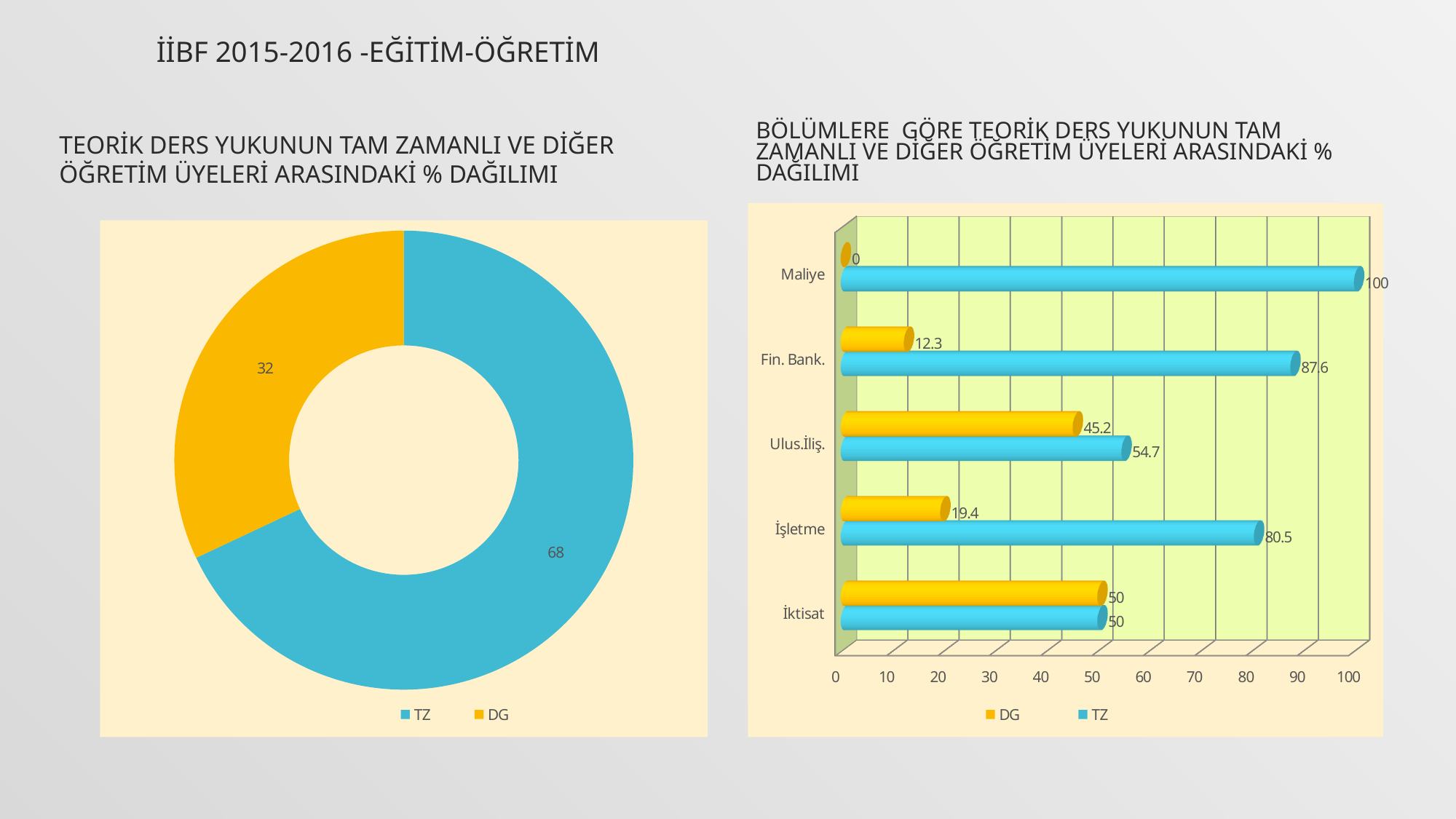
In the left chart (doughnut), what is the value for TZ? 68 In the right chart (bar chart by department), what is the TZ value for İşletme? 80.5 How many departments are shown in the right chart (bar chart by department)? 5 How many series does the legend of the right chart (bar chart by department) list? 2 In the right chart (bar chart by department), what is the difference between the TZ and DG values for Ulus.İliş.? 9.5 What kind of chart is the left chart on the slide? doughnut chart In the right chart (bar chart by department), which department has the lowest TZ value? İktisat In the right chart (bar chart by department), what is the DG value for Fin. Bank.? 12.3 In the left chart (doughnut), which slice is larger, TZ or DG? TZ In the left chart (doughnut), what is the value for DG? 32 In the right chart (bar chart by department), what is the TZ value for Maliye? 100 In the right chart (bar chart by department), which department has the highest DG value? İktisat